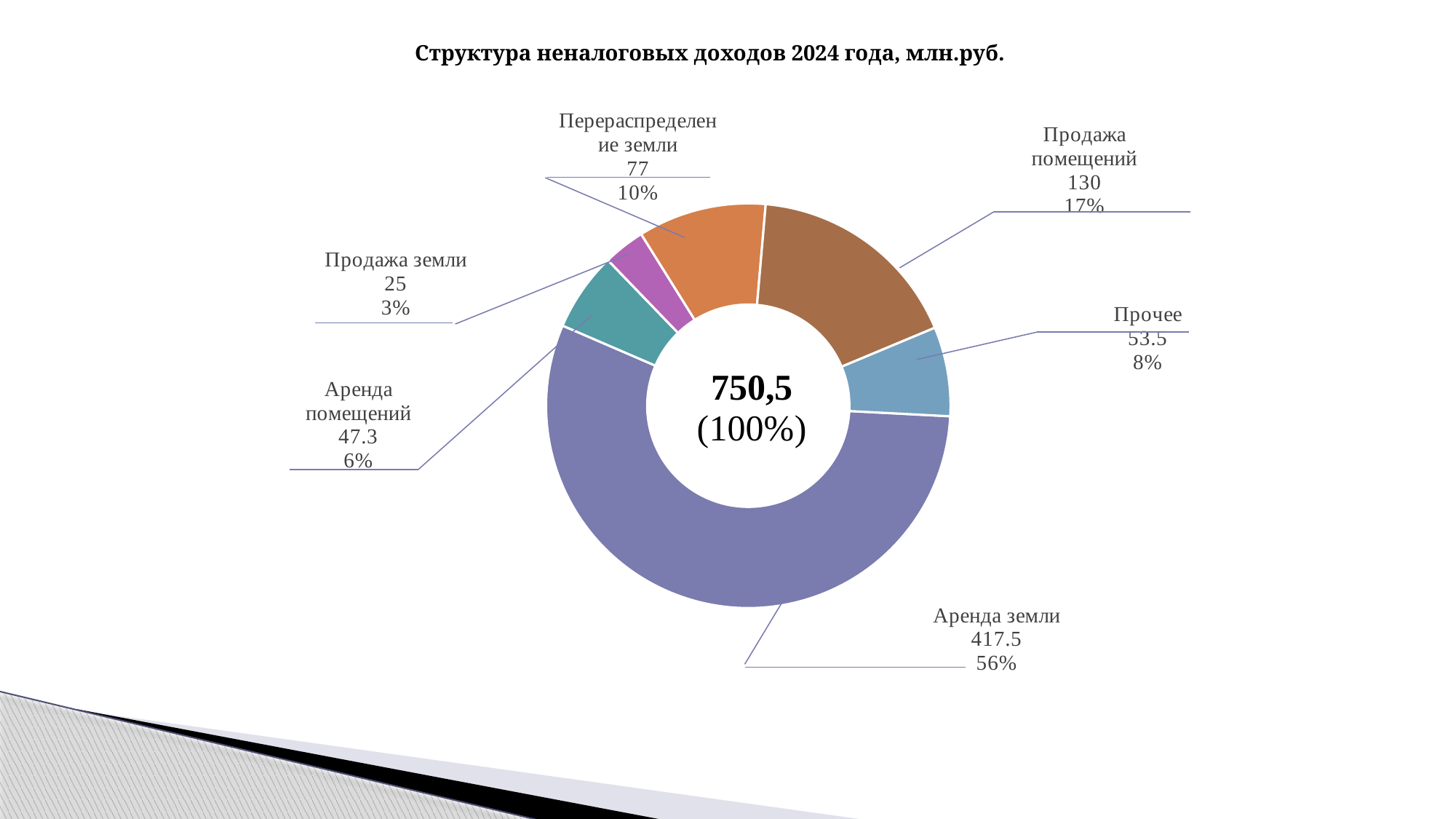
What total value is shown in the centre of the chart? 750,5 (100%) What is the value for Прочее? 53.5 How many categories are shown in the chart? 6 Which category has the largest value? Аренда земли Which category has the smallest value? Продажа земли What is the difference between the values for Продажа помещений and Перераспределение земли? 53 What type of chart is shown on the slide? Doughnut (pie) chart What share of the total does Перераспределение земли represent? 10% Which is larger, the value for Прочее or the value for Аренда помещений? Прочее What is the value for Продажа помещений? 130 What is the value for Аренда земли? 417.5 What share of the total does Аренда помещений represent? 6%